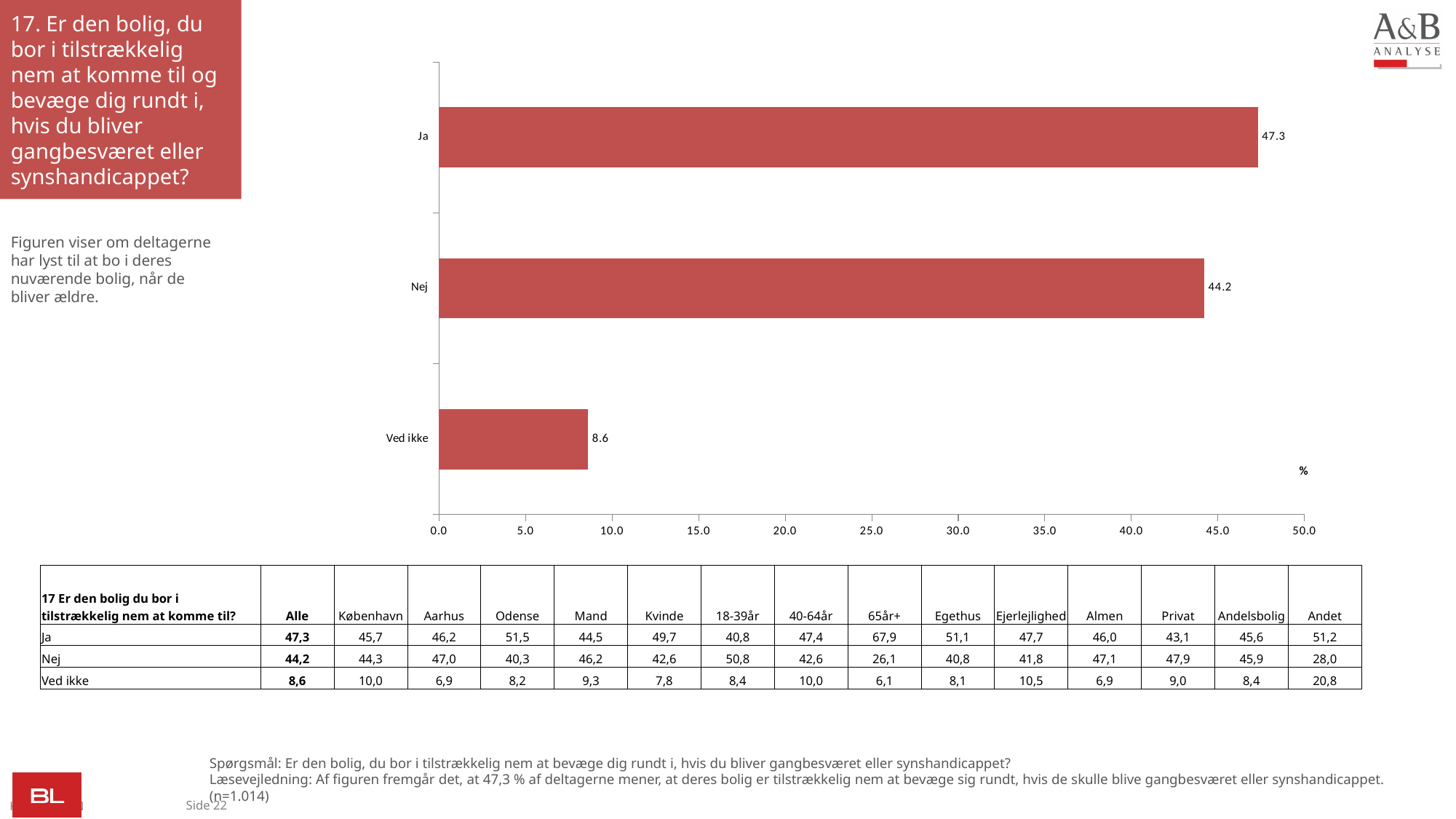
Which category has the lowest value in the bar chart? Ved ikke How many categories are shown in the bar chart? 3 What is the difference between the values for "Nej" and "Ved ikke"? 35.6 What is the value for "Nej" in the bar chart? 44.2 What kind of chart is shown on the slide? Bar chart Is the value for "Nej" greater or less than 40.0? greater Which category has the highest value in the bar chart? Ja What is the difference between the values for "Ja" and "Nej"? 3.1 Which is larger, the value for "Ja" or the value for "Ved ikke"? Ja What is the value for "Ja" in the bar chart? 47.3 Is the value for "Ved ikke" greater or less than 10.0? less What is the value for "Ved ikke" in the bar chart? 8.6